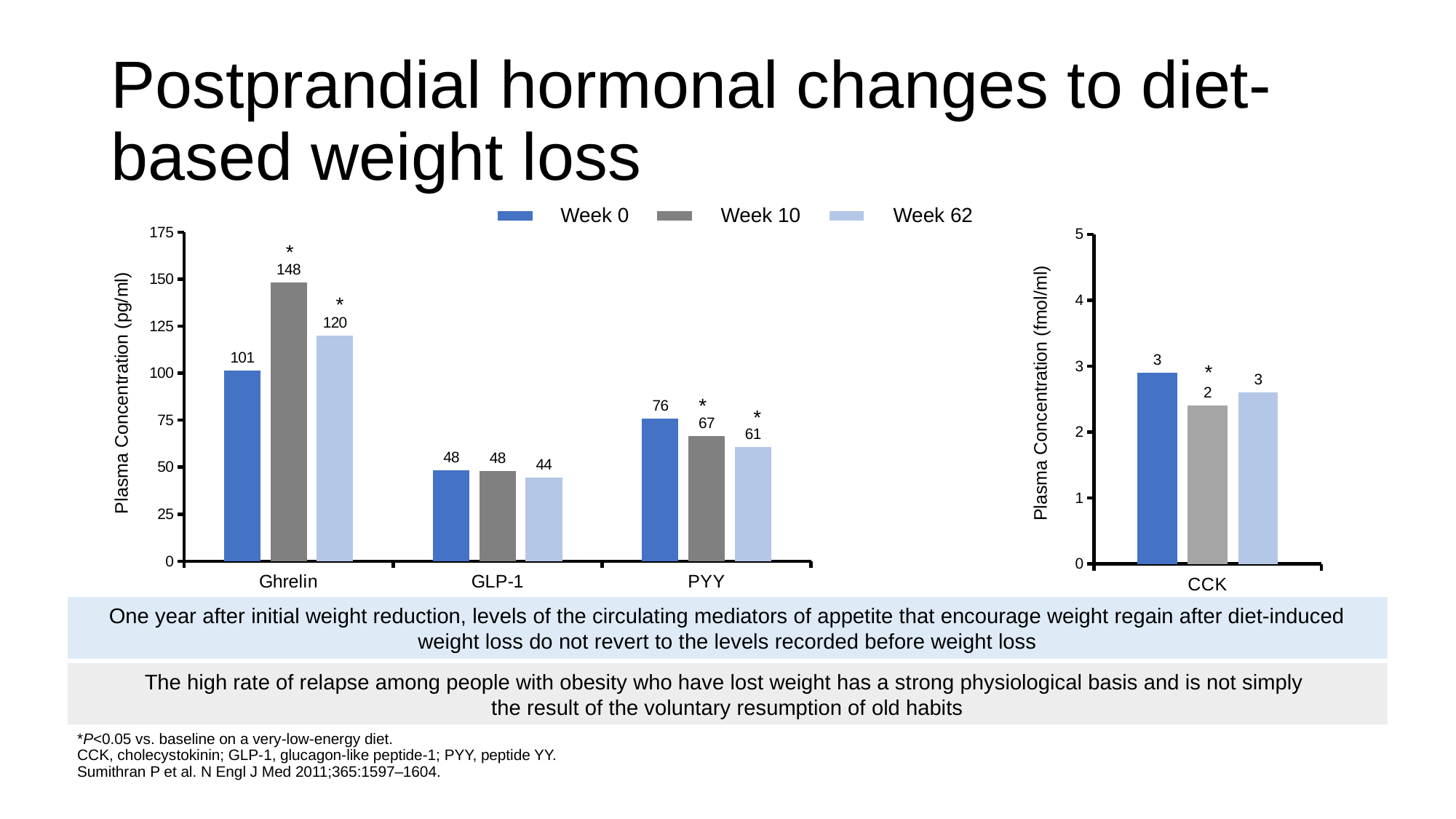
In the left chart, what is the difference between the Ghrelin concentration at Week 10 and at Week 0? 47 In the left chart, at which week is the Ghrelin concentration highest? Week 10 In the left chart, at which week is the PYY concentration lowest? Week 62 In the left chart, what is the plasma concentration of GLP-1 at Week 0? 48 In the left chart, what is the plasma concentration of PYY at Week 62? 61 How many hormone categories are shown on the x axis of the left chart? 3 In the right chart, what is the labelled plasma concentration of CCK at Week 10? 2 In the left chart, do the PYY values rise or fall from Week 0 to Week 62? fall In the left chart, what is the plasma concentration of Ghrelin at Week 10? 148 In the left chart, which is larger: Ghrelin at Week 62 or PYY at Week 0? Ghrelin at Week 62 In the right chart, is the CCK value at Week 10 greater or less than 2? greater How many series does the legend list? 3